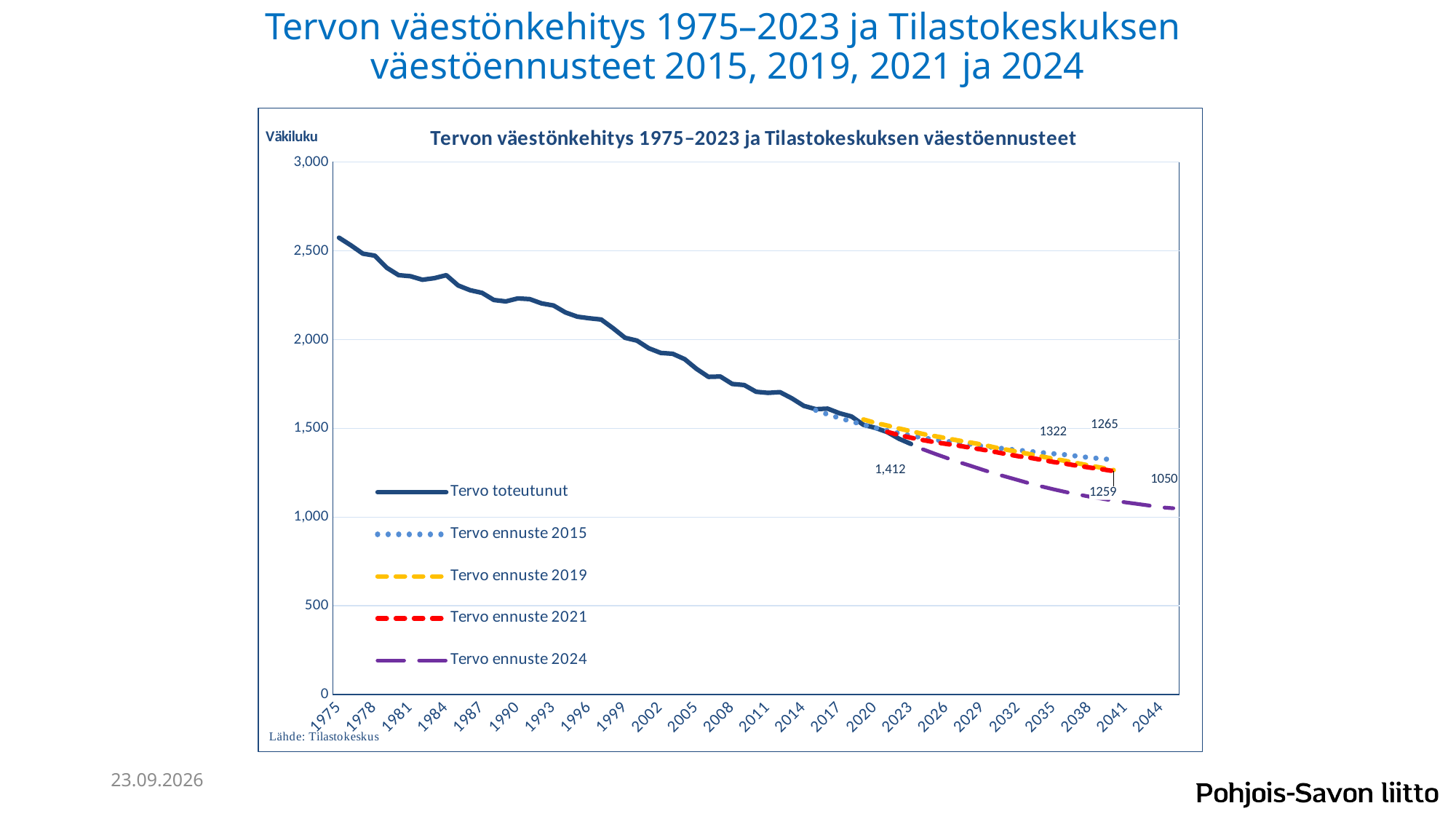
What is the last labelled value of the Tervo toteutunut series? 1,412 Which series ends at a lower value, Tervo ennuste 2024 or Tervo ennuste 2015? Tervo ennuste 2024 What source is cited below the chart? Lähde: Tilastokeskus Is the Tervo toteutunut value in 2005 greater or less than 2,000? less What is the labelled end value of the Tervo ennuste 2015 series? 1322 Does the Tervo toteutunut series rise or fall from 1975 to 2023? fall What kind of chart is shown on the slide? line chart What label is shown on the vertical axis of the chart? Väkiluku What is the difference between the labelled end value of Tervo ennuste 2015 (1322) and that of Tervo ennuste 2024 (1050)? 272 How many series does the legend list? 5 Is the Tervo toteutunut value in 1975 greater or less than 2,500? greater What is the labelled end value of the Tervo ennuste 2024 series? 1050